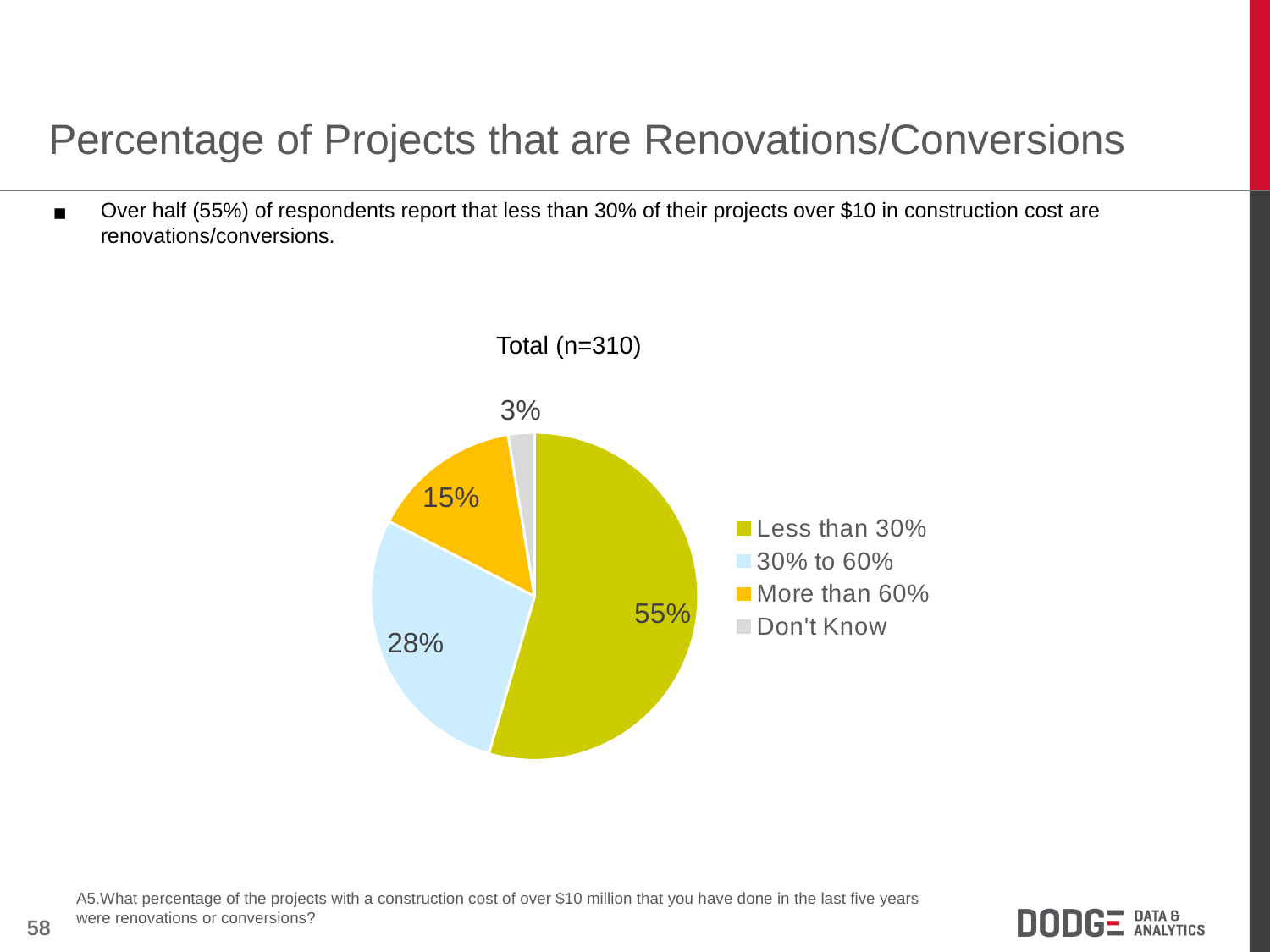
What colour is the 'More than 60%' slice? orange Which category has the largest share of the pie? Less than 30% What percentage of respondents answered 'Less than 30%'? 55% What percentage of respondents answered 'More than 60%'? 15% What percentage of respondents answered '30% to 60%'? 28% What percentage of respondents answered 'Don't Know'? 3% Which category has the smallest share of the pie? Don't Know What type of chart is shown on the slide? pie chart Which is larger, the share for '30% to 60%' or the share for 'More than 60%'? 30% to 60% What is the chart's title? Total (n=310) What is the difference between the 'Less than 30%' share and the '30% to 60%' share? 27% How many categories does the legend list? 4